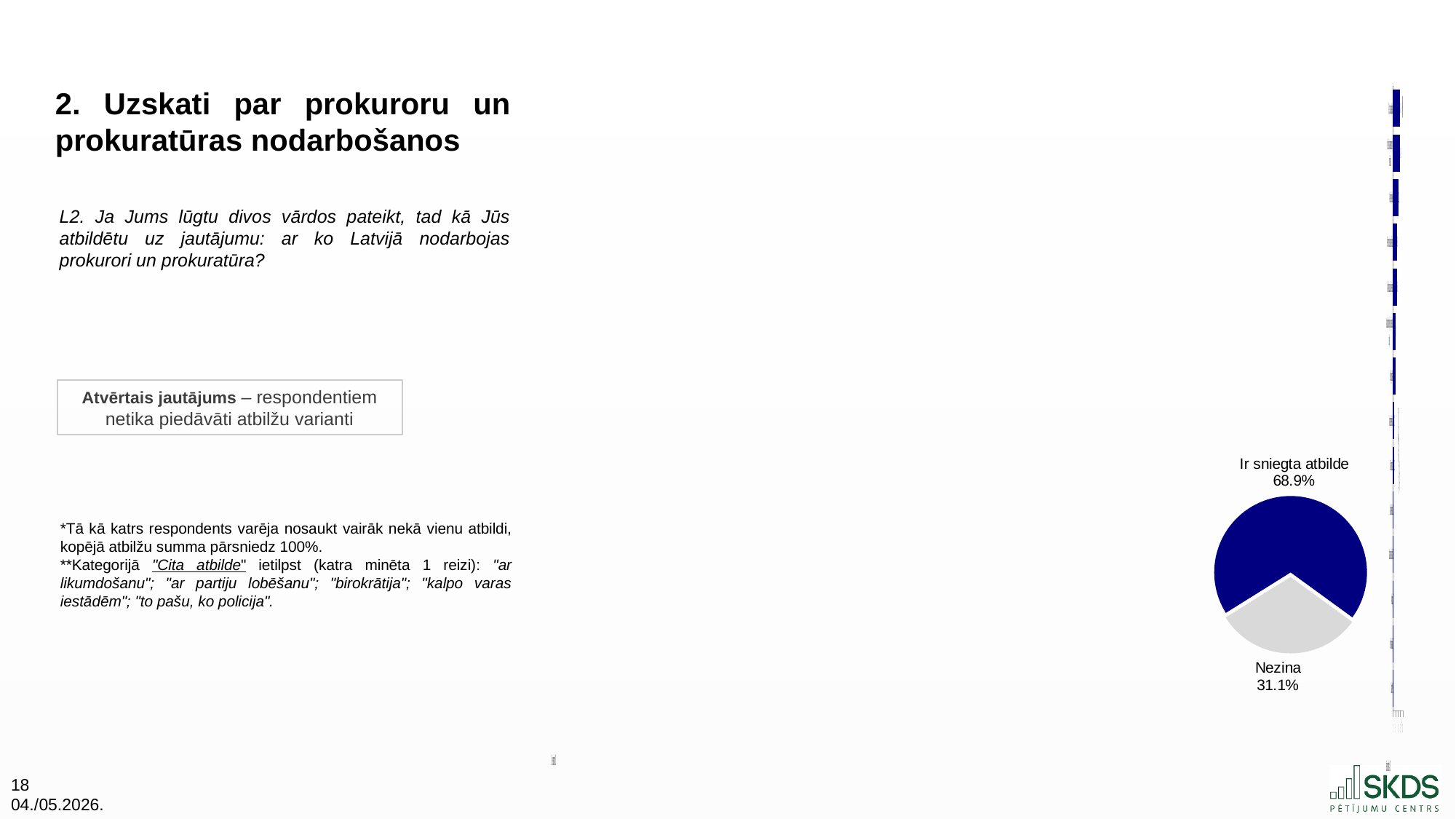
What colour is the "Nezina" slice in the pie chart? grey How many slices does the pie chart have? 2 In the pie chart, what share is labelled "Ir sniegta atbilde"? 68.9% Is the share for "Ir sniegta atbilde" in the pie chart greater or less than 50%? greater Which slice of the pie chart is the smallest? Nezina In the pie chart, what share is labelled "Nezina"? 31.1% In the pie chart, which is larger: "Ir sniegta atbilde" or "Nezina"? Ir sniegta atbilde Is the share for "Nezina" in the pie chart greater or less than 50%? less In the pie chart, what is the difference in percentage points between "Ir sniegta atbilde" and "Nezina"? 37.8 Which slice of the pie chart is the largest? Ir sniegta atbilde What kind of chart is shown at the bottom right of the slide? pie chart What colour is the "Ir sniegta atbilde" slice in the pie chart? dark blue